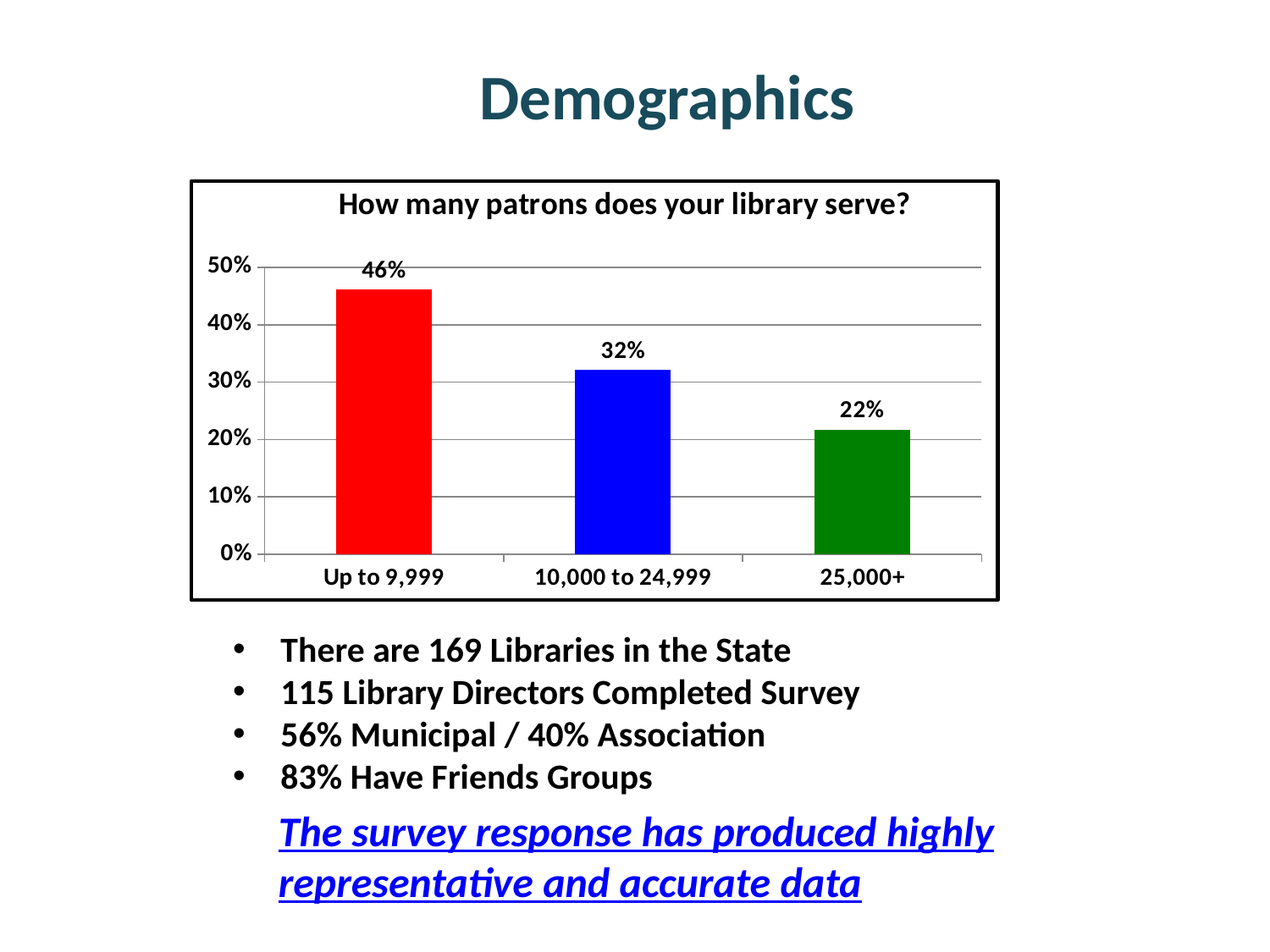
What is the difference between the values for 10,000 to 24,999 and 25,000+? 10% What is the value for the 10,000 to 24,999 category? 32% Which category has the highest value? Up to 9,999 How many categories are shown on the x axis? 3 Which is larger, the value for Up to 9,999 or the value for 10,000 to 24,999? Up to 9,999 What percentage of libraries serve 25,000+ patrons? 22% What is the difference between the values for Up to 9,999 and 25,000+? 24% Do the values rise or fall from left to right along the x axis? fall Is the value for 10,000 to 24,999 greater or less than 40%? less What kind of chart is shown on the slide? bar chart Which category has the lowest value? 25,000+ What percentage of libraries serve up to 9,999 patrons? 46%